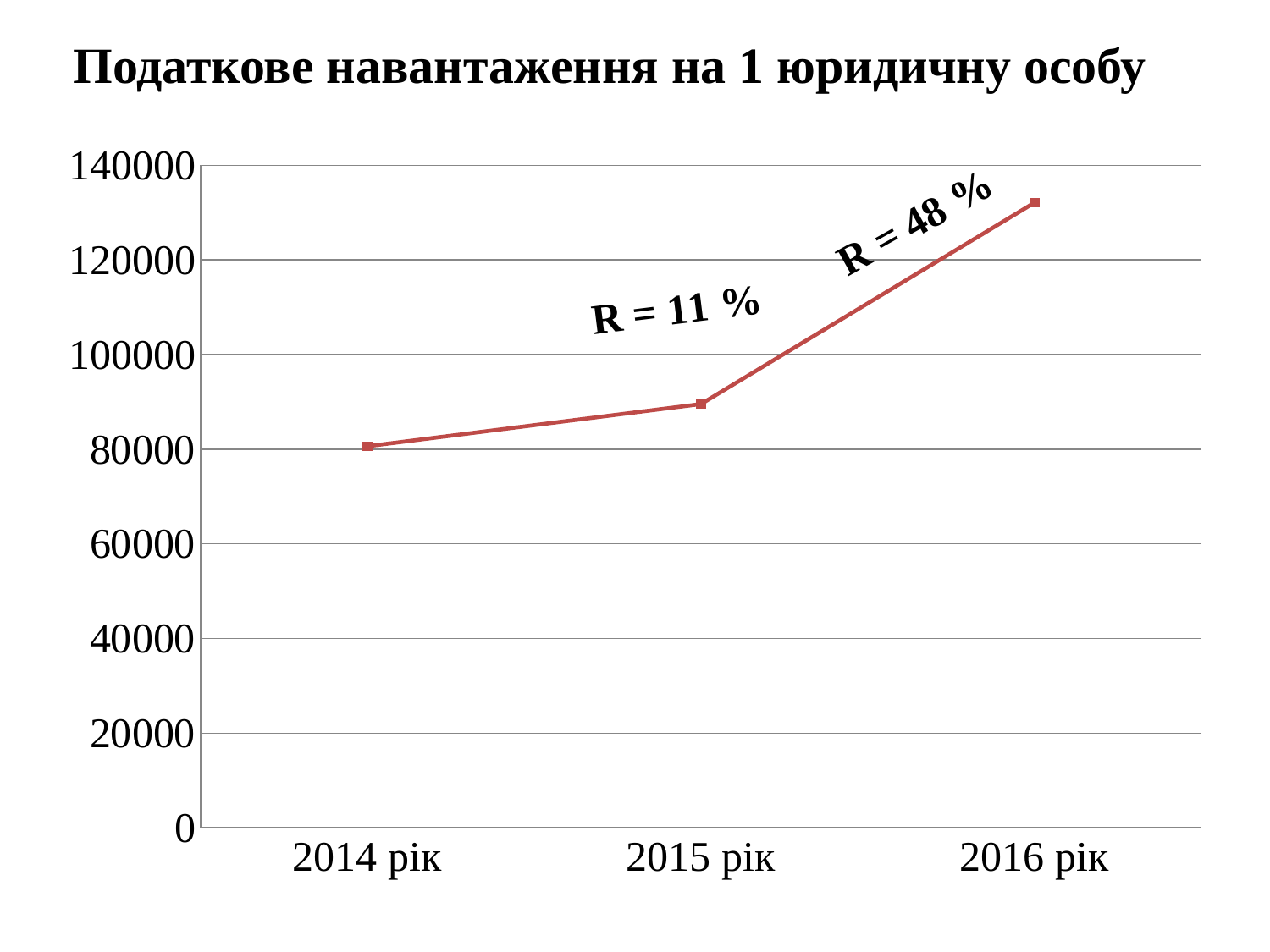
How many data points are plotted on the chart? 3 Which year has the lowest value on the chart? 2014 рік What kind of chart is shown on the slide? line chart What growth rate (R) is annotated on the segment between 2015 рік and 2016 рік? R = 48 % Which is larger, the value for 2015 рік or the value for 2016 рік? 2016 рік Do the values rise or fall from 2014 рік to 2016 рік? rise Which year has the highest value on the chart? 2016 рік Is the value for 2016 рік greater or less than 120000? greater What is the title of the chart? Податкове навантаження на 1 юридичну особу Is the value for 2015 рік greater or less than 80000? greater Is the value for 2014 рік greater or less than 100000? less